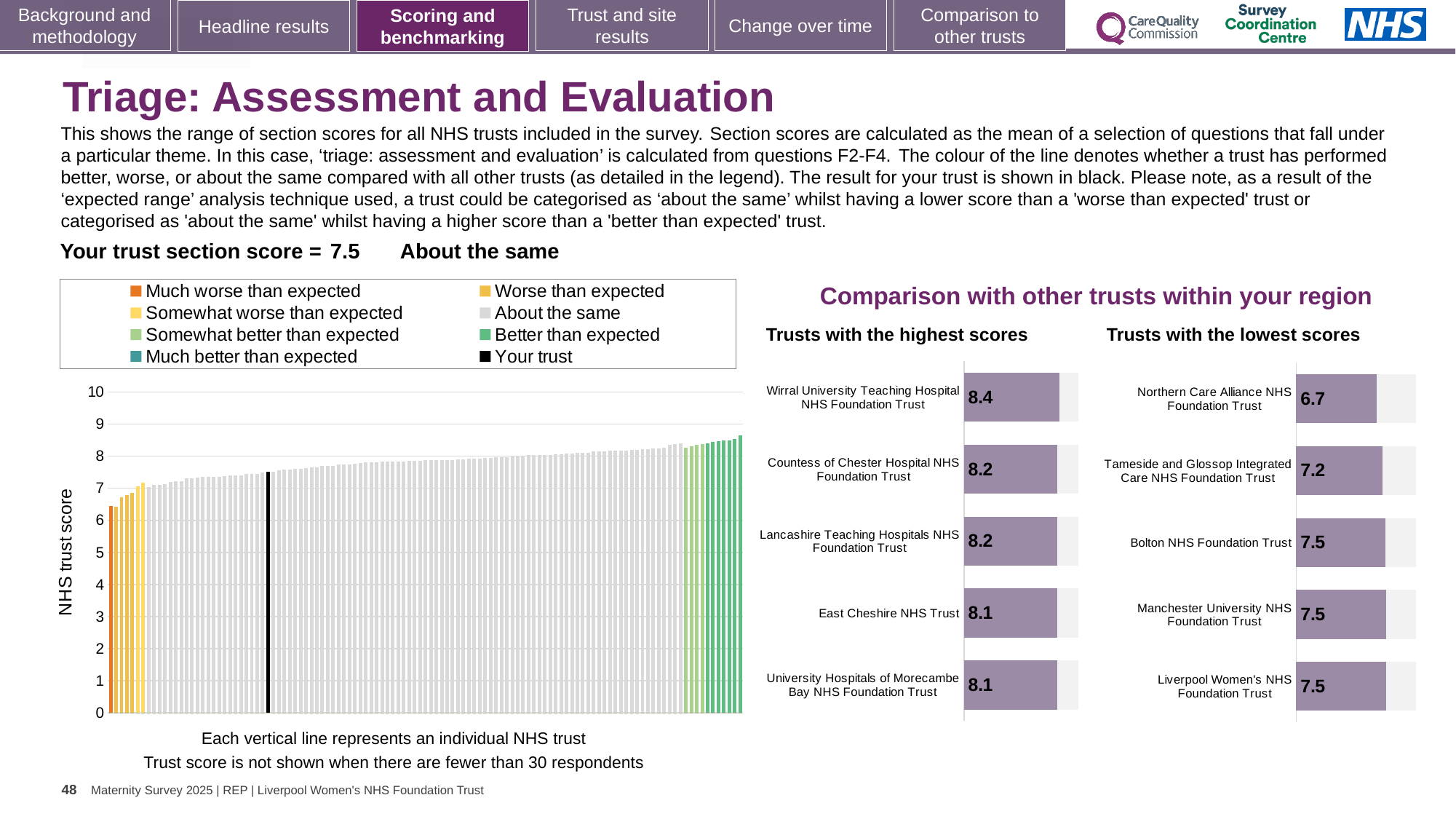
In the 'Trusts with the lowest scores' chart, what is the difference between the scores of Tameside and Glossop Integrated Care NHS Foundation Trust and Northern Care Alliance NHS Foundation Trust? 0.5 Which is larger: the score for Countess of Chester Hospital NHS Foundation Trust in the highest scores chart, or the score for Bolton NHS Foundation Trust in the lowest scores chart? Countess of Chester Hospital NHS Foundation Trust In the 'Trusts with the lowest scores' chart, which trust has the lowest score? Northern Care Alliance NHS Foundation Trust In the 'Trusts with the highest scores' chart, what is the difference between the scores of Wirral University Teaching Hospital NHS Foundation Trust and East Cheshire NHS Trust? 0.3 In the 'Trusts with the highest scores' chart, what is the score for Wirral University Teaching Hospital NHS Foundation Trust? 8.4 In the main 'NHS trust score' chart on the left, do the bar values rise or fall from left to right? rise In the main 'NHS trust score' chart on the left, is the value for the black 'Your trust' bar greater or less than 7? greater In the 'Trusts with the highest scores' chart, which trust has the highest score? Wirral University Teaching Hospital NHS Foundation Trust How many entries does the legend of the main 'NHS trust score' chart list? 8 In the 'Trusts with the lowest scores' chart, what is the score for Tameside and Glossop Integrated Care NHS Foundation Trust? 7.2 How many trusts are shown in the 'Trusts with the highest scores' chart? 5 In the 'Trusts with the lowest scores' chart, what is the score for Northern Care Alliance NHS Foundation Trust? 6.7